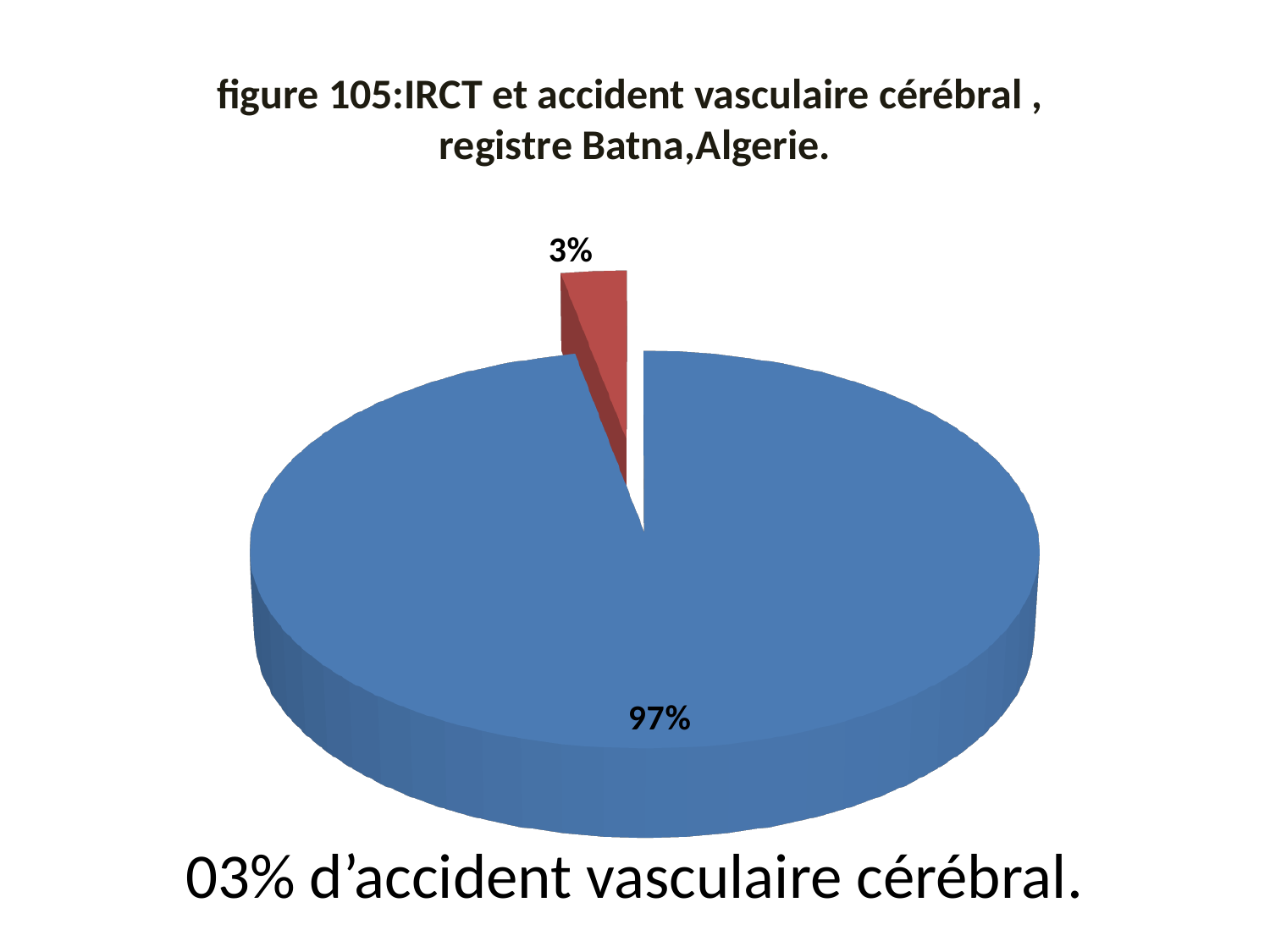
How many slices does the pie chart have? 2 Which is larger, the red slice or the blue slice? the blue slice What is the difference in percentage points between the blue slice and the red slice? 94 What share of the pie does the red slice represent? 3% What kind of chart is shown on the slide? pie chart Which slice of the pie chart is the smallest? the red slice (3%) What percentage is shown on the blue slice of the pie chart? 97% What colour is the slice labelled 97%? blue What is the title of the chart? figure 105:IRCT et accident vasculaire cérébral , registre Batna,Algerie. What percentage is shown on the red slice of the pie chart? 3% Which slice of the pie chart is the largest? the blue slice (97%)